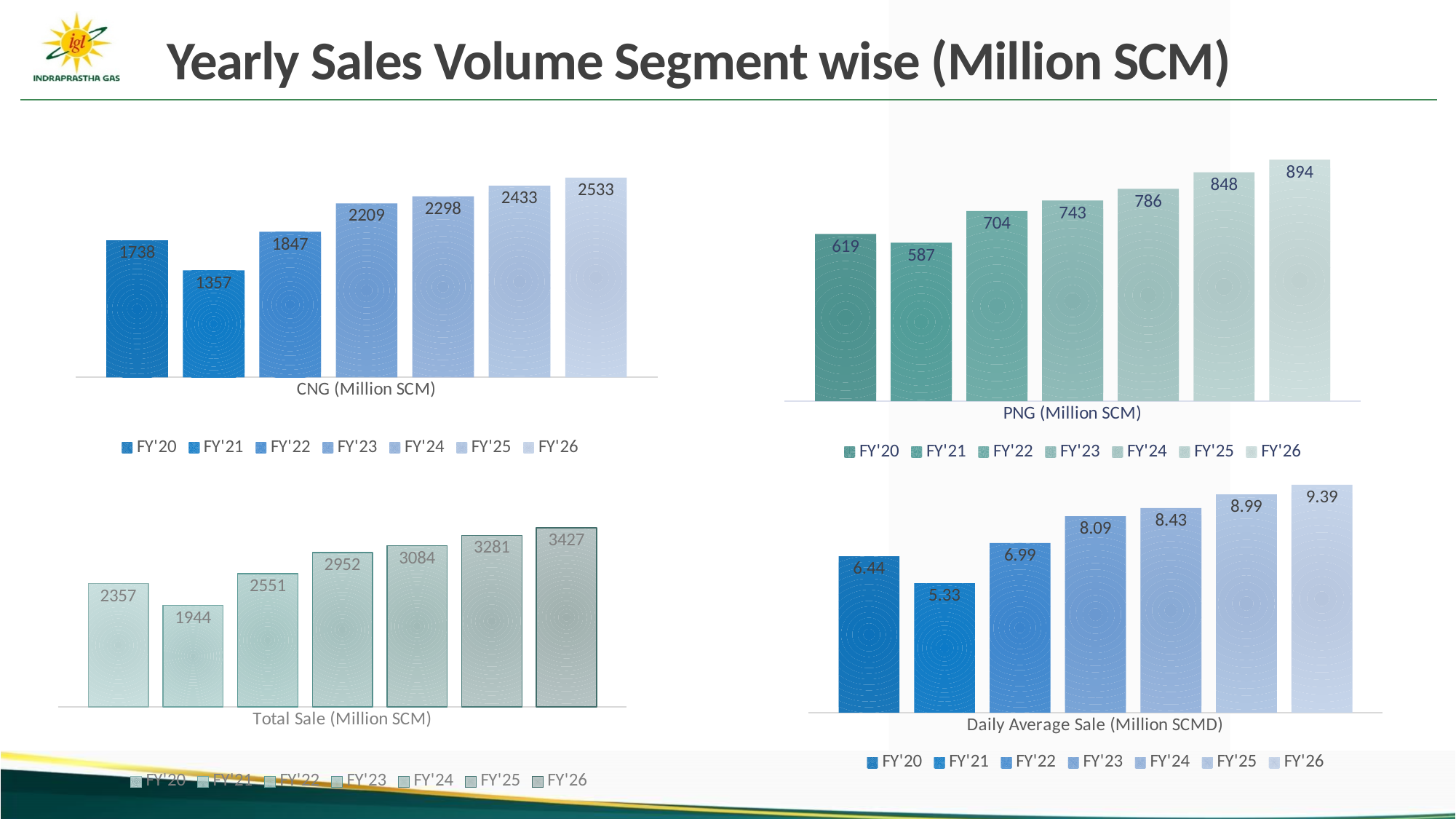
In the Daily Average Sale (Million SCMD) chart, do the values rise or fall from FY'21 to FY'26? rise In the Total Sale (Million SCM) chart, what is the difference between the FY'25 and FY'24 values? 197 How many bars are shown in the Daily Average Sale (Million SCMD) chart? 7 In the Total Sale (Million SCM) chart, which fiscal year has the highest value? FY'26 In the PNG (Million SCM) chart, what is the value for FY'26? 894 In the CNG (Million SCM) chart, which is larger, the value for FY'20 or the value for FY'22? FY'22 In the PNG (Million SCM) chart, what is the difference between the FY'26 and FY'20 values? 275 What type of chart is the Total Sale (Million SCM) chart? bar chart How many entries does the legend of the PNG (Million SCM) chart list? 7 In the Daily Average Sale (Million SCMD) chart, what is the value for FY'21? 5.33 In the CNG (Million SCM) chart, what is the value for FY'23? 2209 In the CNG (Million SCM) chart, which fiscal year has the lowest value? FY'21